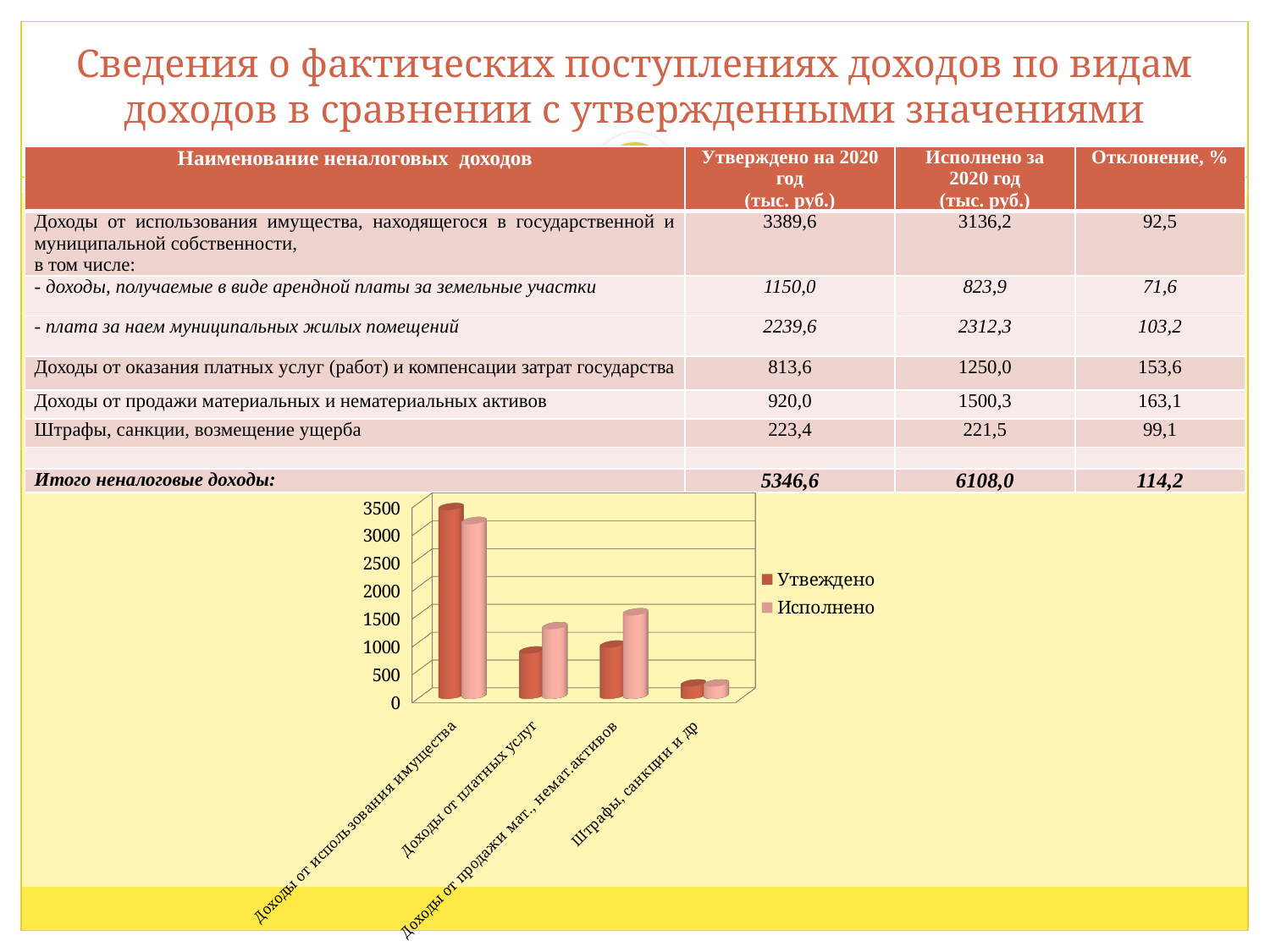
What are the two series named in the chart legend? Утвеждено and Исполнено Which category has the lowest Исполнено bar in the chart? Штрафы, санкции и др Is the Исполнено value for Штрафы, санкции и др greater or less than 500? less What kind of chart is shown on the slide? bar chart Is the Исполнено value for Доходы от платных услуг greater or less than 1000? greater Which category has the highest Утвеждено bar in the chart? Доходы от использования имущества How many categories are shown on the chart's x axis? 4 Is the Утвеждено value for Доходы от использования имущества greater or less than 3000? greater How many series does the chart legend list? 2 For Доходы от продажи мат., немат.активов, which bar is taller: Утвеждено or Исполнено? Исполнено For Доходы от использования имущества, which bar is taller: Утвеждено or Исполнено? Утвеждено